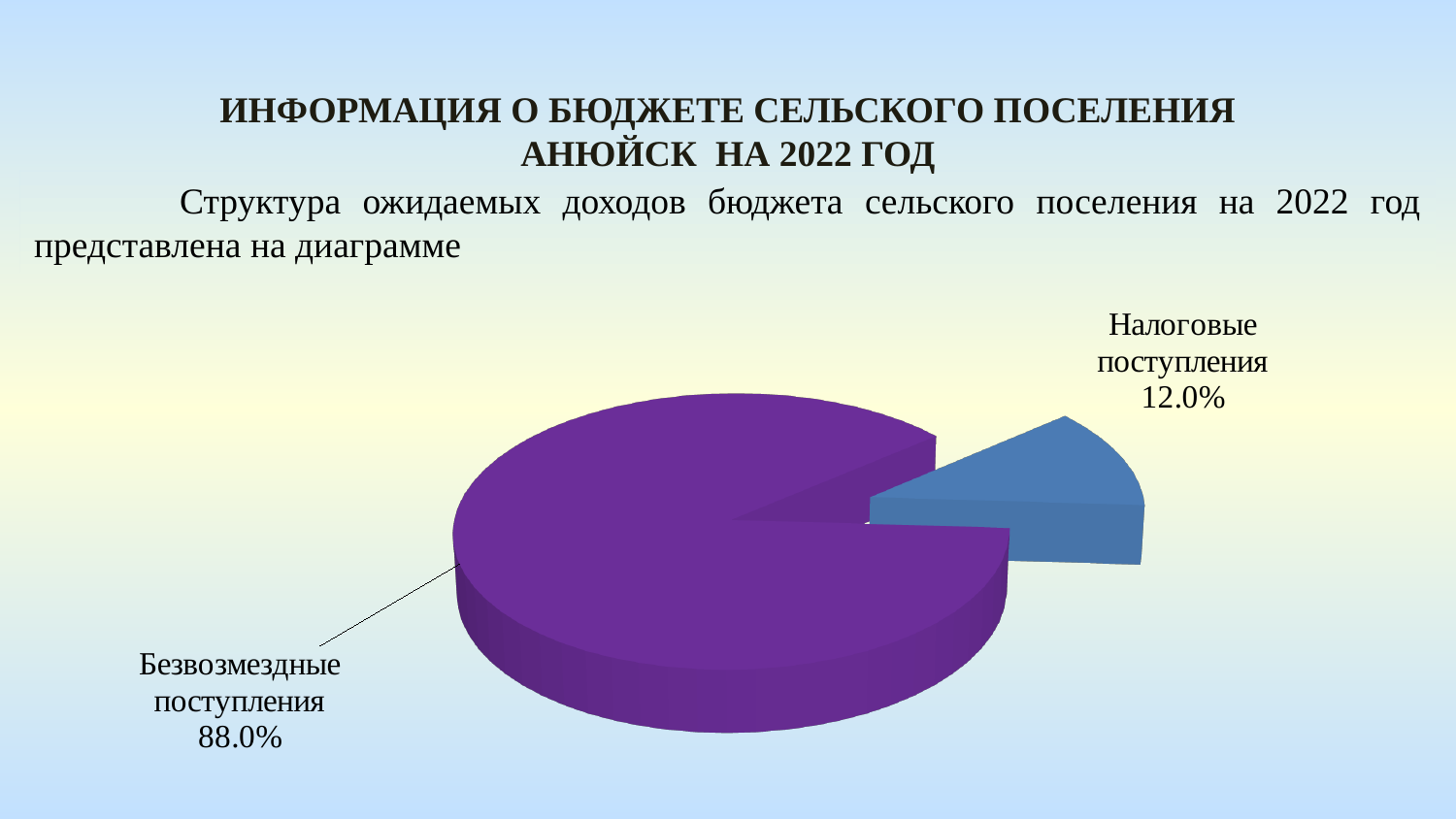
Which is larger: "Налоговые поступления" or "Безвозмездные поступления"? Безвозмездные поступления What colour is the slice for "Налоговые поступления"? Blue What is the total of the two slice percentages shown? 100.0% How many slices does the pie chart have? 2 Which slice of the pie is the smallest? Налоговые поступления What colour is the slice for "Безвозмездные поступления"? Purple What is the difference in percentage points between "Безвозмездные поступления" and "Налоговые поступления"? 76.0 Which slice of the pie is the largest? Безвозмездные поступления What share of the pie is labelled "Налоговые поступления"? 12.0% What share of the pie is labelled "Безвозмездные поступления"? 88.0% What kind of chart is shown on the slide? Pie chart